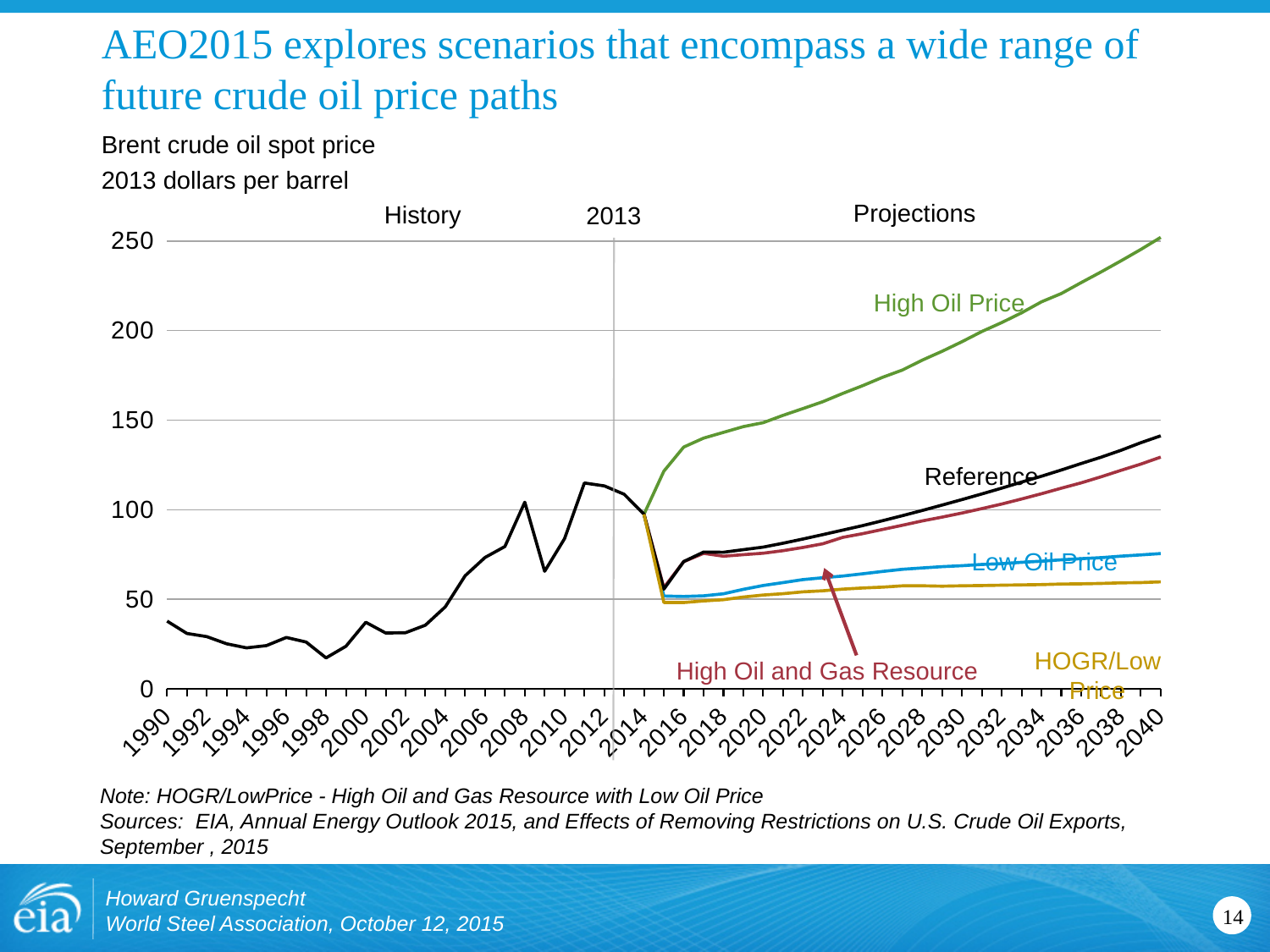
Is the historical Brent crude oil spot price in 1998 greater or less than 50? less How many projection scenarios are labelled on the chart? 5 Does the High Oil Price line rise or fall from 2014 to 2040? rise Is the Low Oil Price value in 2040 greater or less than 100? less What kind of chart is shown on the slide? line chart Which scenario has the highest Brent crude oil spot price in 2040? High Oil Price Is the Reference value in 2040 greater or less than 150? less Which scenario has the lowest Brent crude oil spot price in 2040? HOGR/Low Price In 2040, which is larger: the Reference price or the High Oil and Gas Resource price? Reference In what units is the Brent crude oil spot price shown on the chart? 2013 dollars per barrel